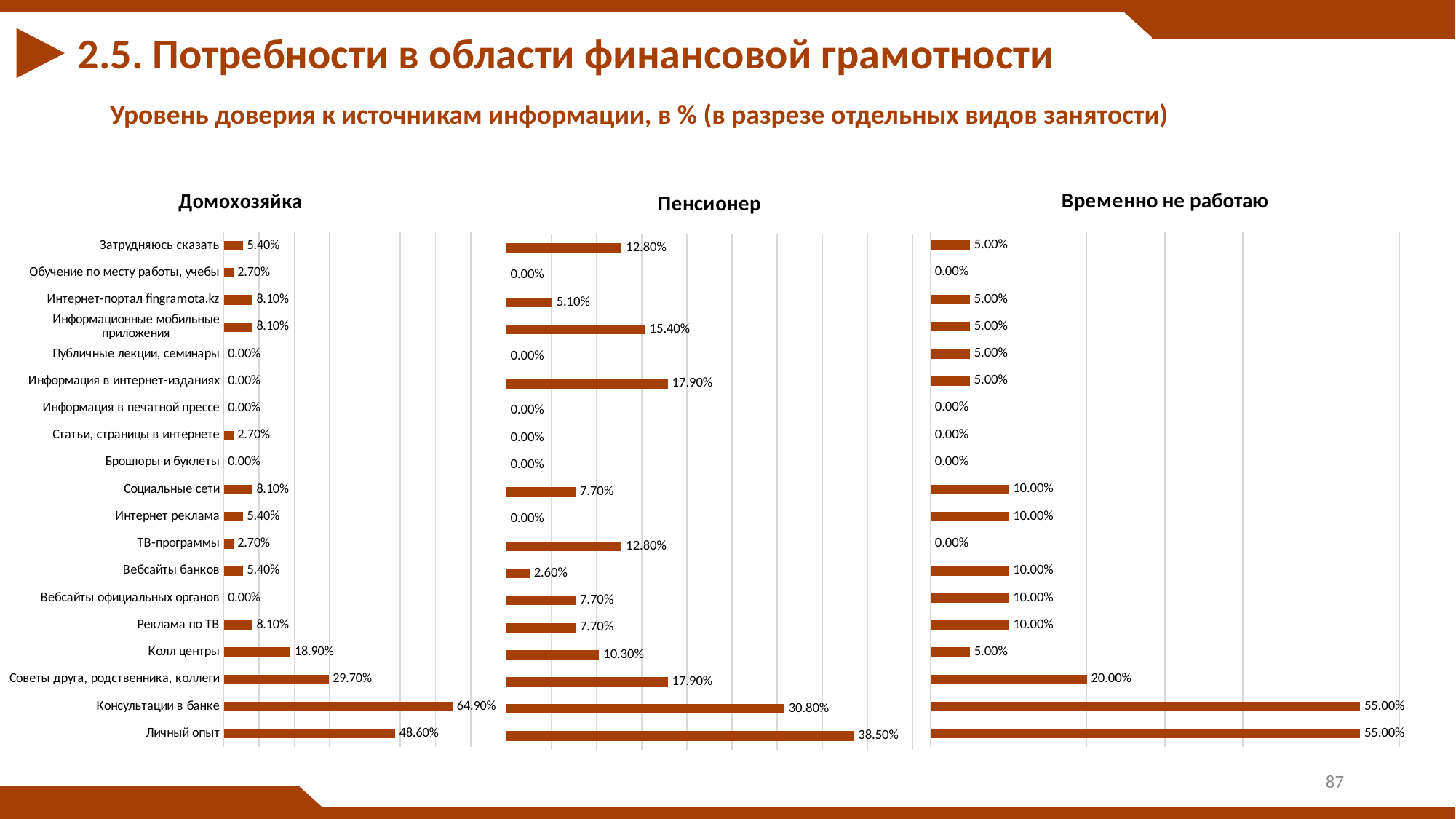
In the Пенсионер chart, which category has the highest value? Личный опыт In the Домохозяйка chart, what is the difference between Консультации в банке and Личный опыт? 16.30% In the Пенсионер chart, which is larger: Затрудняюсь сказать or Интернет-портал fingramota.kz? Затрудняюсь сказать In the Домохозяйка chart, which category has the highest value? Консультации в банке How many categories does the Домохозяйка chart show? 19 In the Временно не работаю chart, which is larger: Социальные сети or Колл центры? Социальные сети In the Пенсионер chart, what is the difference between Личный опыт and Консультации в банке? 7.70% In the Домохозяйка chart, what is the value for Консультации в банке? 64.90% In the Пенсионер chart, what is the value for Личный опыт? 38.50% What is the value for Колл центры in the Домохозяйка chart? 18.90% In the Временно не работаю chart, what is the value for Советы друга, родственника, коллеги? 20.00% What type of chart is the Пенсионер chart? Bar chart